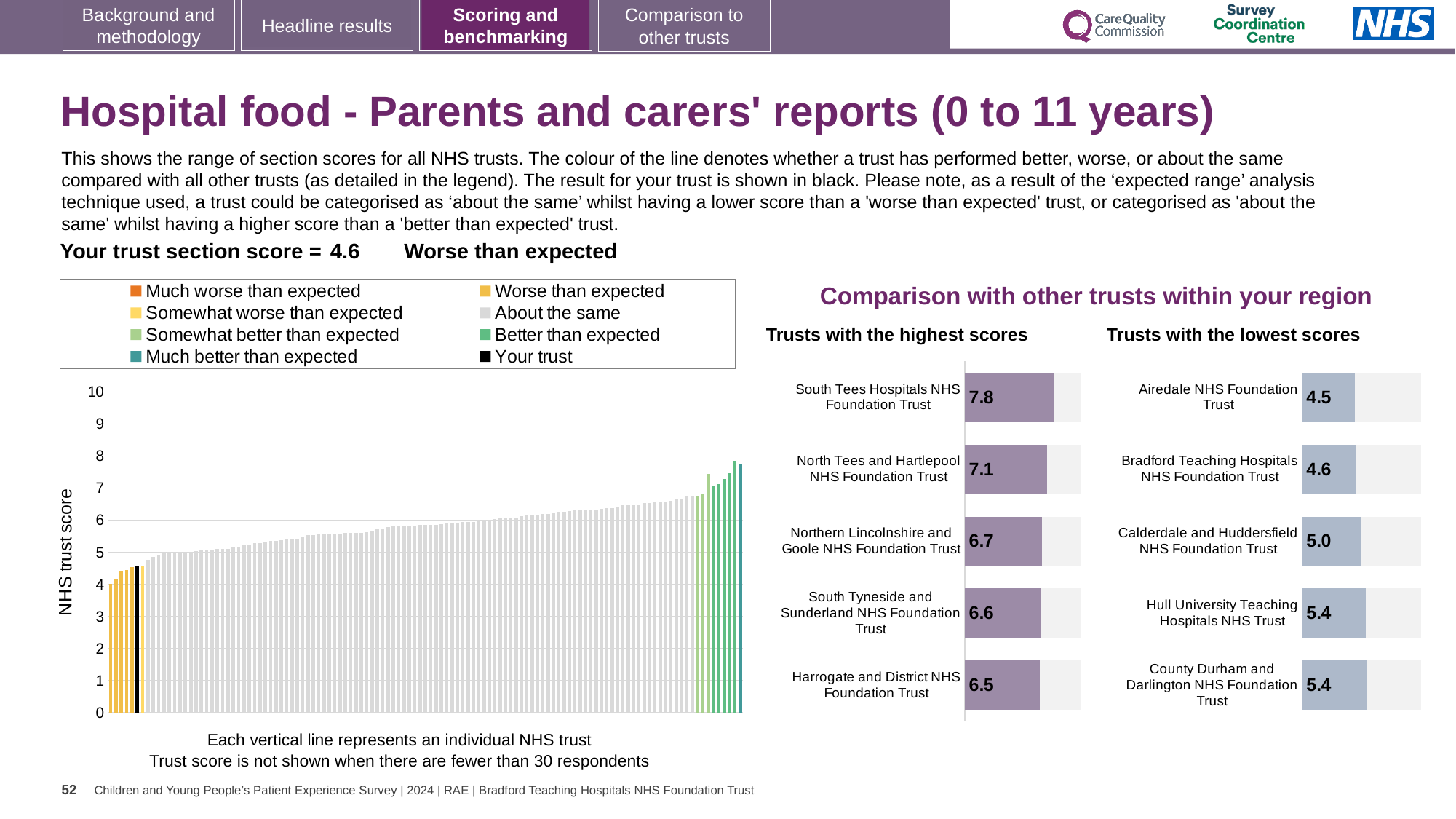
In the 'Trusts with the highest scores' chart, what is the score for Northern Lincolnshire and Goole NHS Foundation Trust? 6.7 In the 'Trusts with the lowest scores' chart, which has the larger score: Calderdale and Huddersfield NHS Foundation Trust or Airedale NHS Foundation Trust? Calderdale and Huddersfield NHS Foundation Trust In the 'Trusts with the highest scores' chart, what is the difference between the scores of South Tees Hospitals NHS Foundation Trust and Harrogate and District NHS Foundation Trust? 1.3 In the 'Trusts with the lowest scores' chart, which trust has the lowest score? Airedale NHS Foundation Trust In the 'Trusts with the highest scores' chart, which trust has the lowest score? Harrogate and District NHS Foundation Trust How many entries does the legend of the left-hand NHS trust score chart list? 8 In the 'Trusts with the lowest scores' chart, what is the score for Bradford Teaching Hospitals NHS Foundation Trust? 4.6 In the 'Trusts with the highest scores' chart, what is the score for South Tees Hospitals NHS Foundation Trust? 7.8 What kind of chart is the large chart on the left showing NHS trust scores? Bar chart In the 'Trusts with the lowest scores' chart, what is the difference between the scores of Calderdale and Huddersfield NHS Foundation Trust and Airedale NHS Foundation Trust? 0.5 In the 'Trusts with the highest scores' chart, how many trusts are shown? 5 In the 'Trusts with the lowest scores' chart, what is the score for Airedale NHS Foundation Trust? 4.5